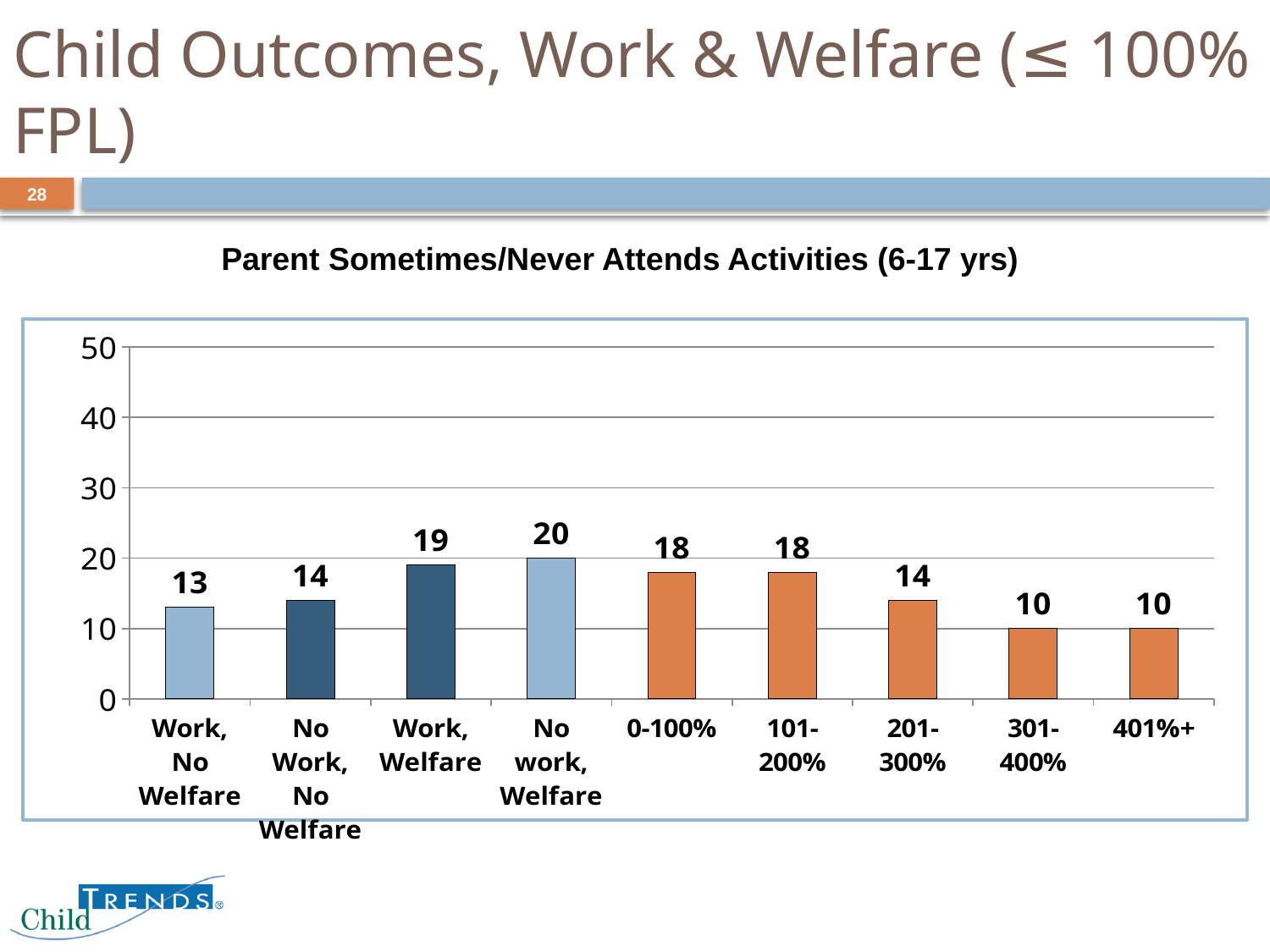
What is the difference between the values for 'Work, Welfare' and 'Work, No Welfare'? 6 What is the difference between the values for '201-300%' and '401%+'? 4 What is the value for the 'Work, No Welfare' category? 13 What kind of chart is shown on the slide? bar chart Do the values rise or fall across the income categories from '0-100%' to '401%+'? fall Is the value for '301-400%' greater or less than 20? less How many categories are shown on the x axis? 9 What is the value for the '0-100%' category? 18 What is the title of the chart? Parent Sometimes/Never Attends Activities (6-17 yrs) Which category has the highest value? No work, Welfare What is the value for the 'No work, Welfare' category? 20 Which is larger, the value for 'No Work, No Welfare' or the value for '101-200%'? 101-200%